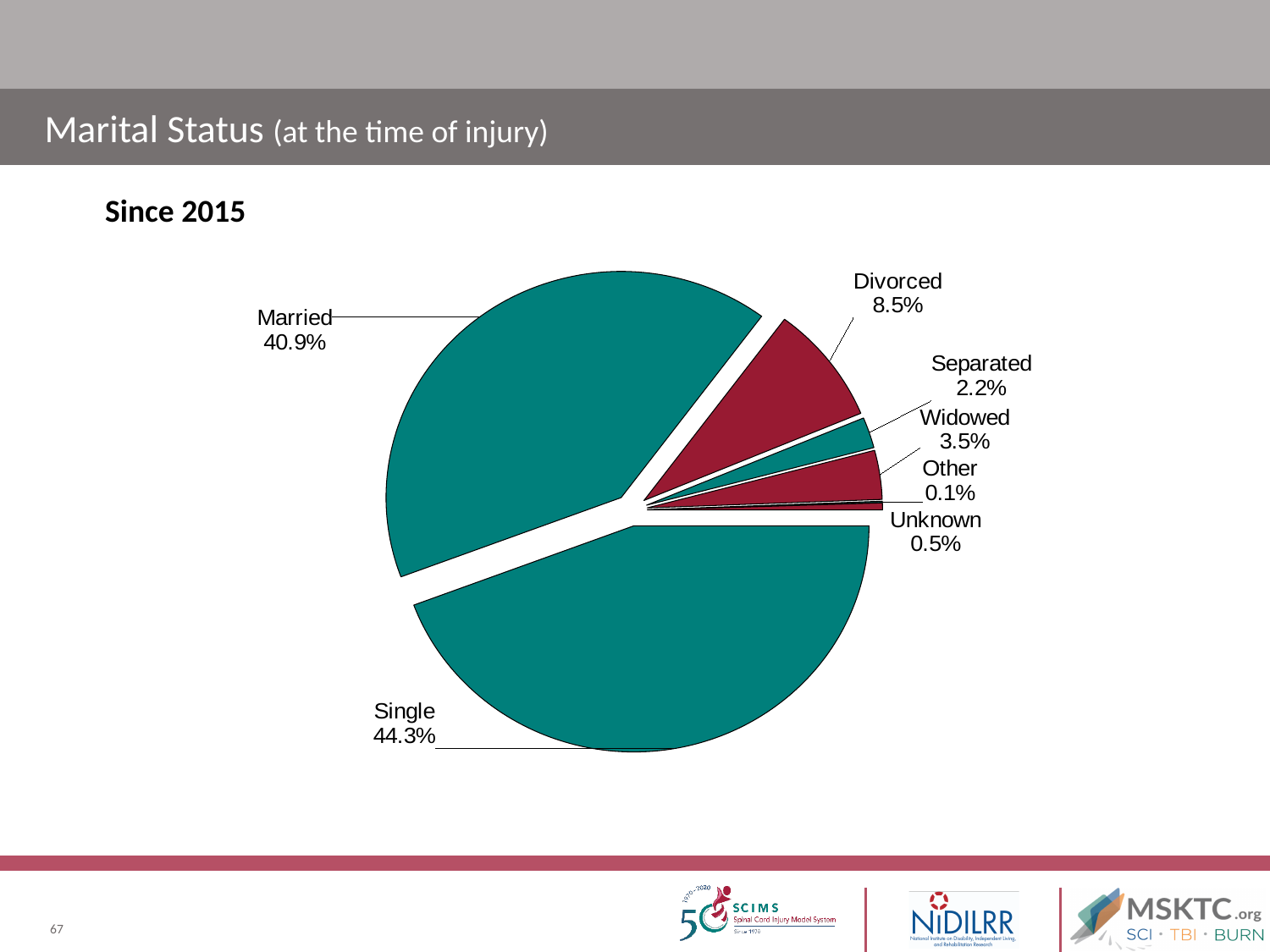
What percentage of the pie is Married? 40.9% What kind of chart is shown on the slide? Pie chart What percentage of the pie is Separated? 2.2% What is the difference in percentage points between Single and Married? 3.4 Which marital status category has the largest share of the pie? Single What percentage of the pie is Single? 44.3% What percentage of the pie is Widowed? 3.5% Which is larger, the share for Divorced or the share for Widowed? Divorced How many categories are shown in the pie chart? 7 What time period does the chart cover, according to the label above it? Since 2015 Which marital status category has the smallest share of the pie? Other What percentage of the pie is Divorced? 8.5%